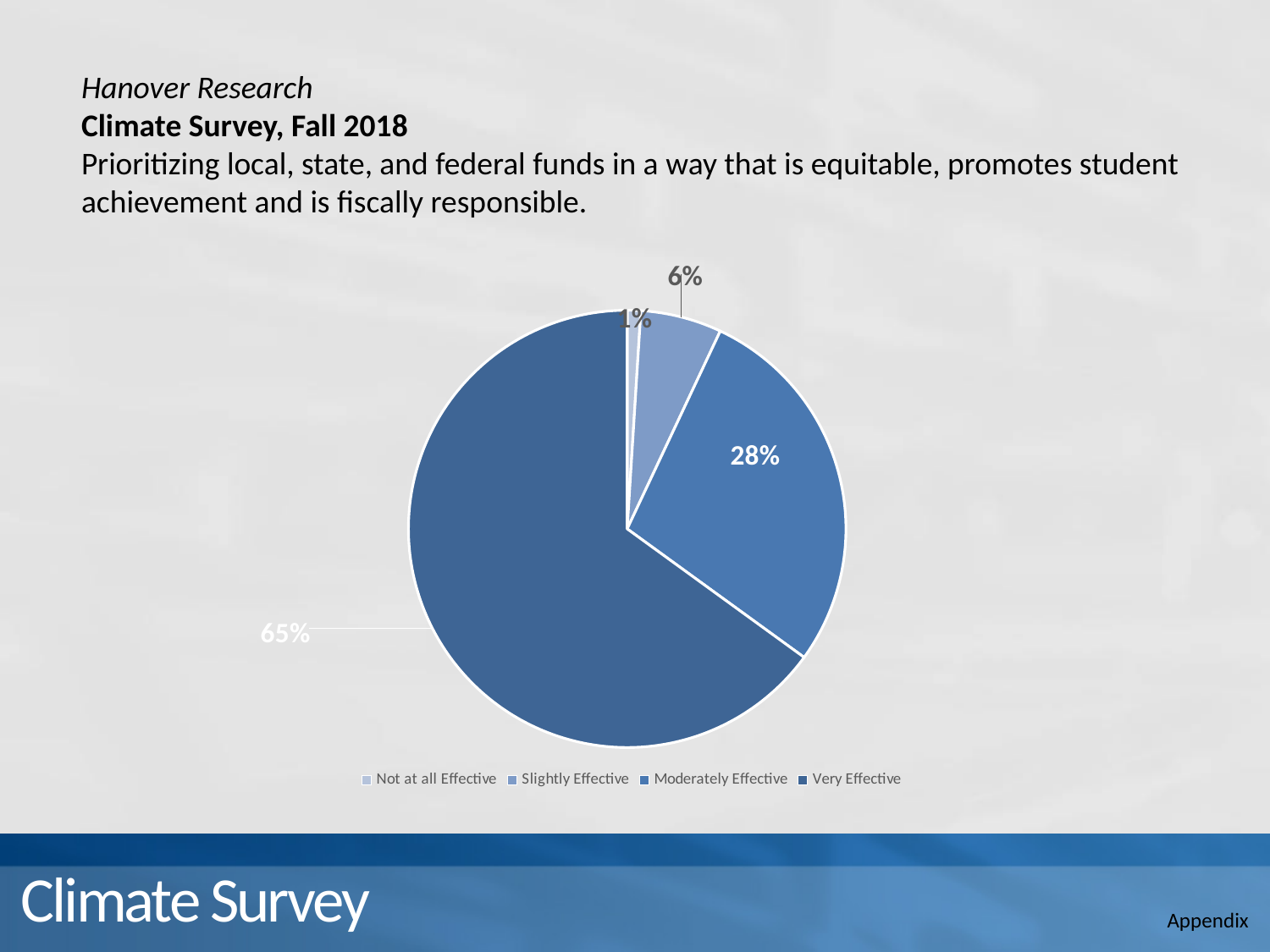
Which response category has the smallest share of the pie? Not at all Effective How many categories does the legend list? 4 What is the combined percentage for Very Effective and Moderately Effective? 93% What is the title of the survey shown above the chart? Climate Survey, Fall 2018 What kind of chart is shown on the slide? Pie chart What is the difference in percentage points between Very Effective and Moderately Effective? 37 What percentage of respondents rated this as Moderately Effective? 28% Which response category has the largest share of the pie? Very Effective What percentage of respondents rated this as Very Effective? 65% What percentage of respondents rated this as Slightly Effective? 6% Which is larger, the share for Slightly Effective or the share for Moderately Effective? Moderately Effective What percentage of respondents rated this as Not at all Effective? 1%